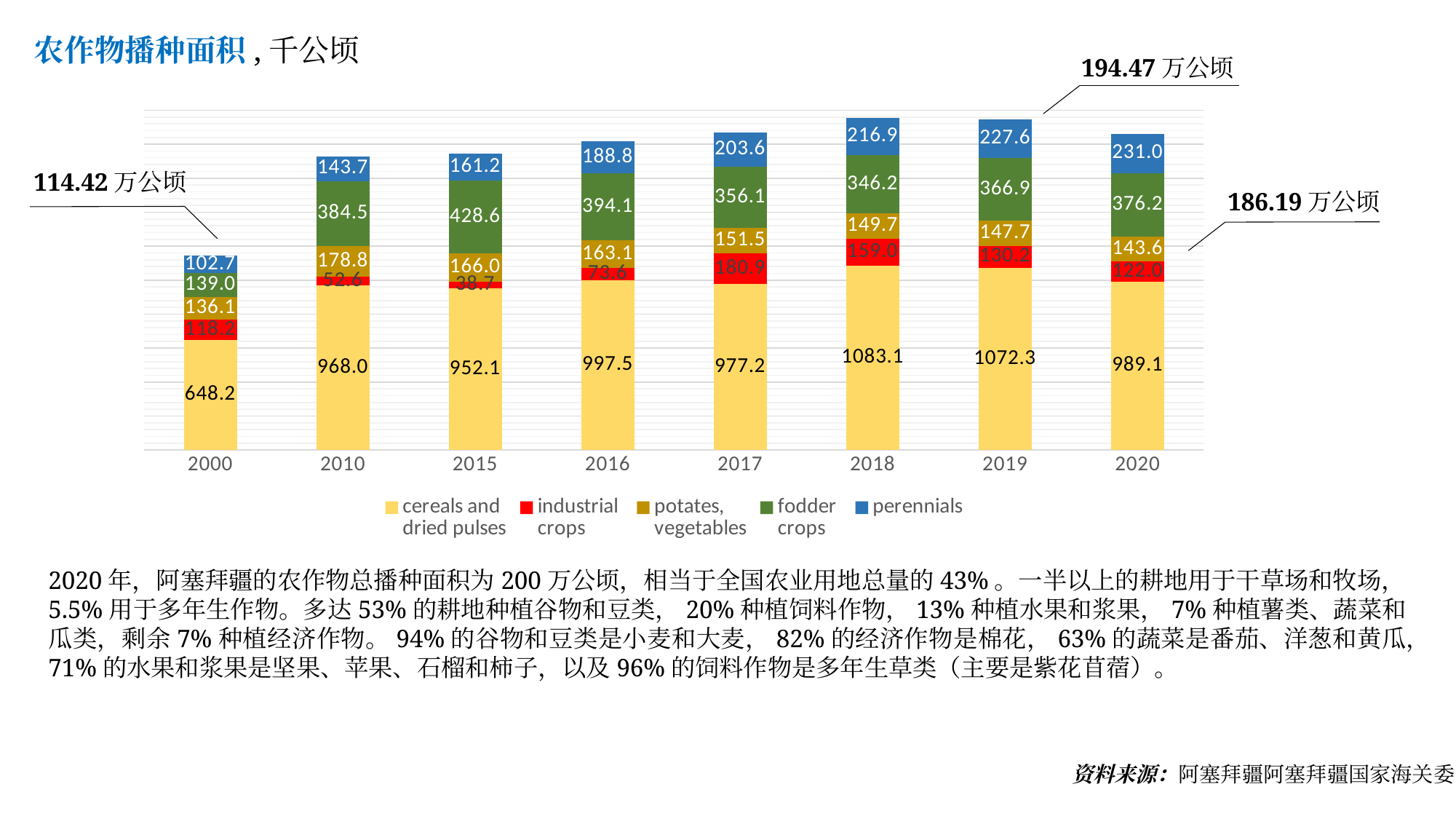
Do the perennials values rise or fall from 2000 to 2020? rise What is the total of the stacked bar for 2000? 1144.2 In which year is the industrial crops value lowest? 2015 What kind of chart is shown on the slide? stacked bar chart How many series does the legend list? 5 What is the value for cereals and dried pulses in 2018? 1083.1 What is the value for fodder crops in 2015? 428.6 What is the value for perennials in 2020? 231.0 What is the difference between the perennials value in 2020 and in 2000? 128.3 In which year is the cereals and dried pulses value highest? 2018 Which is larger, the fodder crops value in 2010 or in 2016? 2016 How many years are shown on the x axis? 8